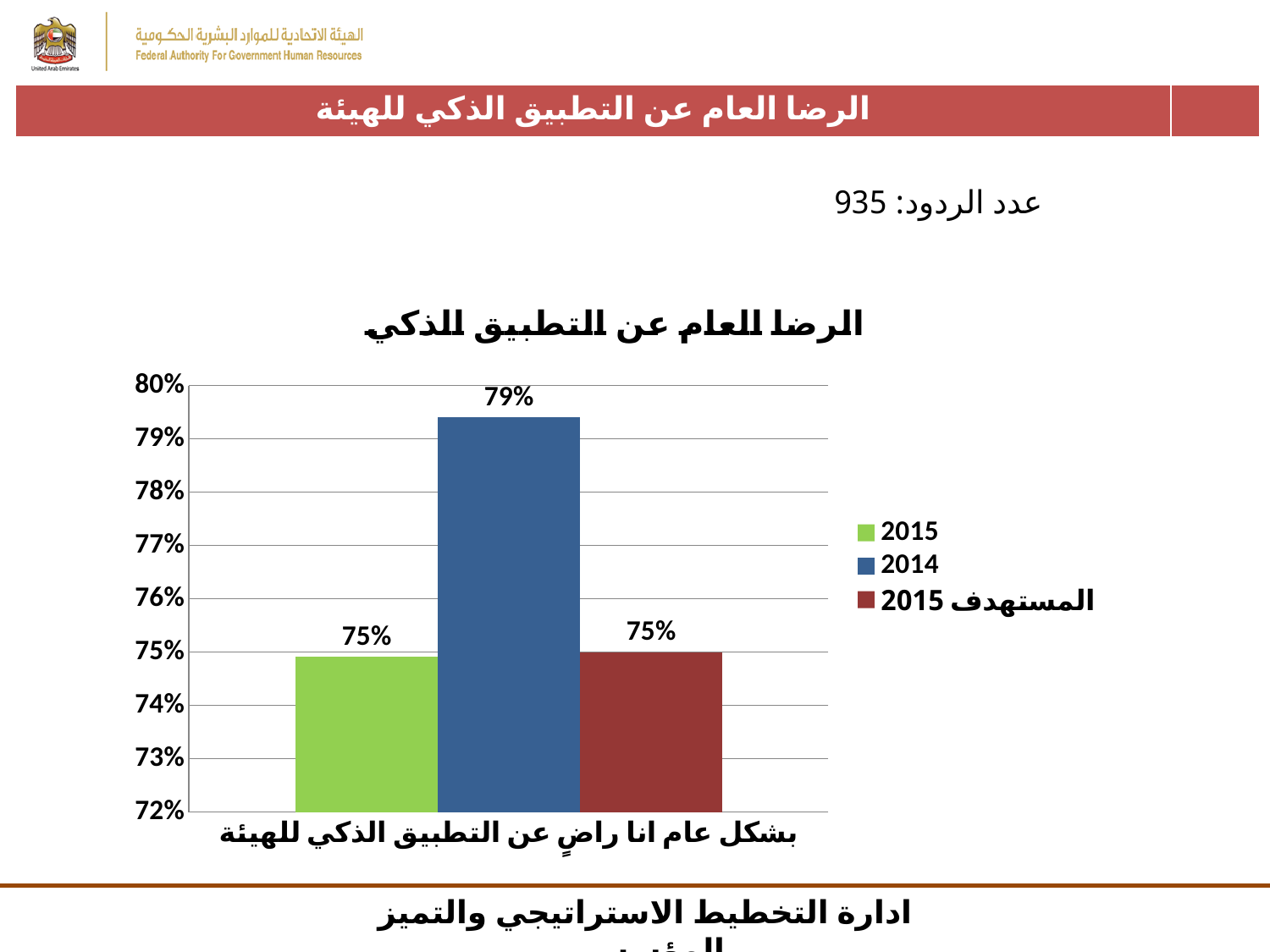
What is the value for the المستهدف 2015 series in the chart? 75% What is the value for the 2015 series in the chart? 75% Is the value for 2014 greater or less than 78%? greater What is the value for the 2014 series in the chart? 79% How many series does the legend list? 3 Which series has the highest value in the chart? 2014 Is the value for 2015 greater or less than 77%? less What colour is the bar for the 2014 series? blue What is the difference between the 2014 value and the 2015 value? 4% What kind of chart is shown on the slide? bar chart Which is larger, the value for 2014 or the value for 2015? 2014 What is the difference between the 2014 value and the المستهدف 2015 value? 4%